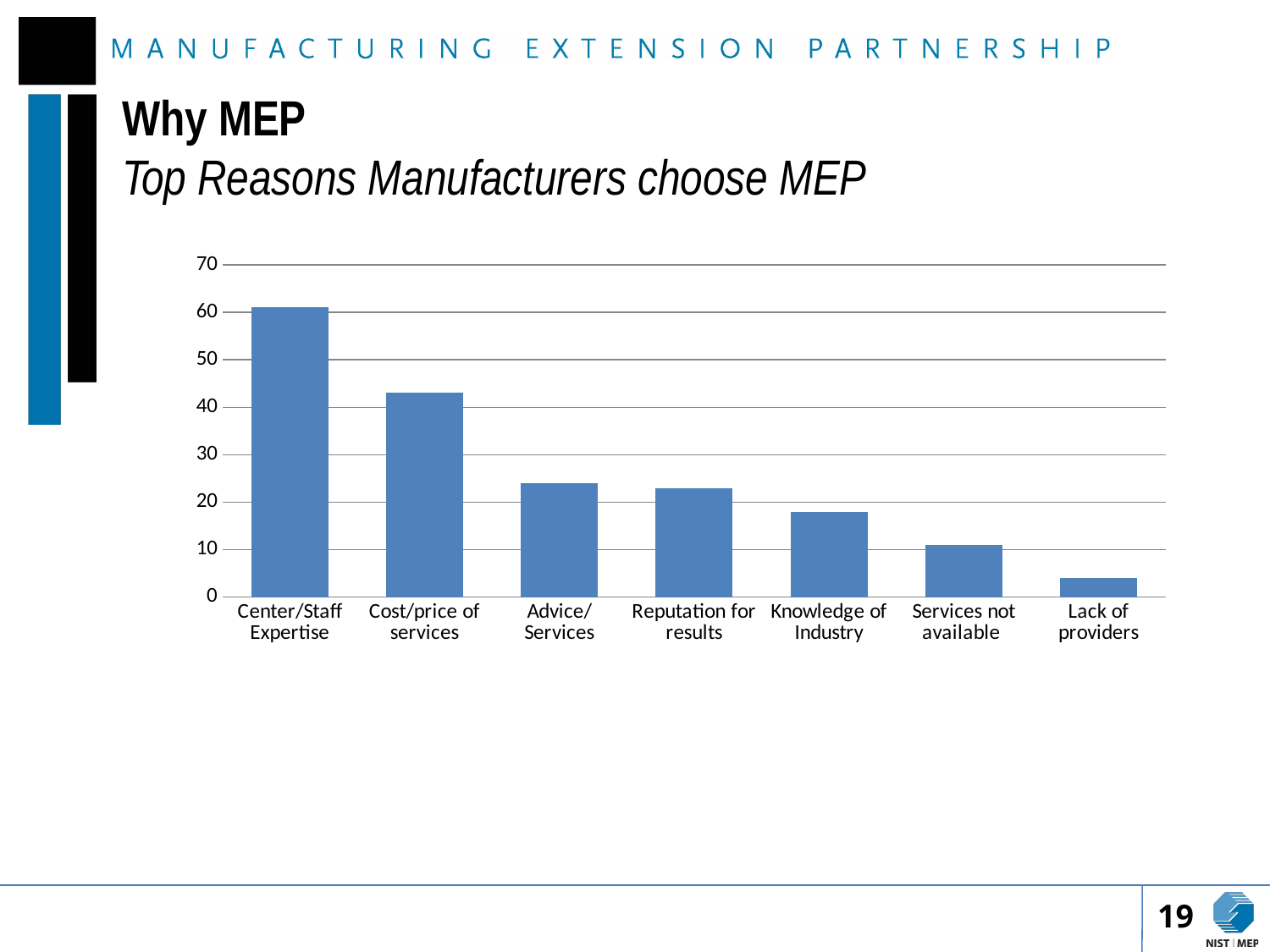
What kind of chart is shown on the slide? bar chart Do the bar values rise or fall moving from left to right along the x axis? fall Is the value for Lack of providers greater or less than 10? less Which reason has the highest value on the chart? Center/Staff Expertise Is the value for Center/Staff Expertise greater or less than 50? greater How many categories (reasons) are shown on the chart? 7 Which is larger, the value for Cost/price of services or the value for Advice/Services? Cost/price of services Which reason has the lowest value on the chart? Lack of providers Is the value for Services not available greater or less than 20? less What is the subtitle of the slide describing the chart? Top Reasons Manufacturers choose MEP